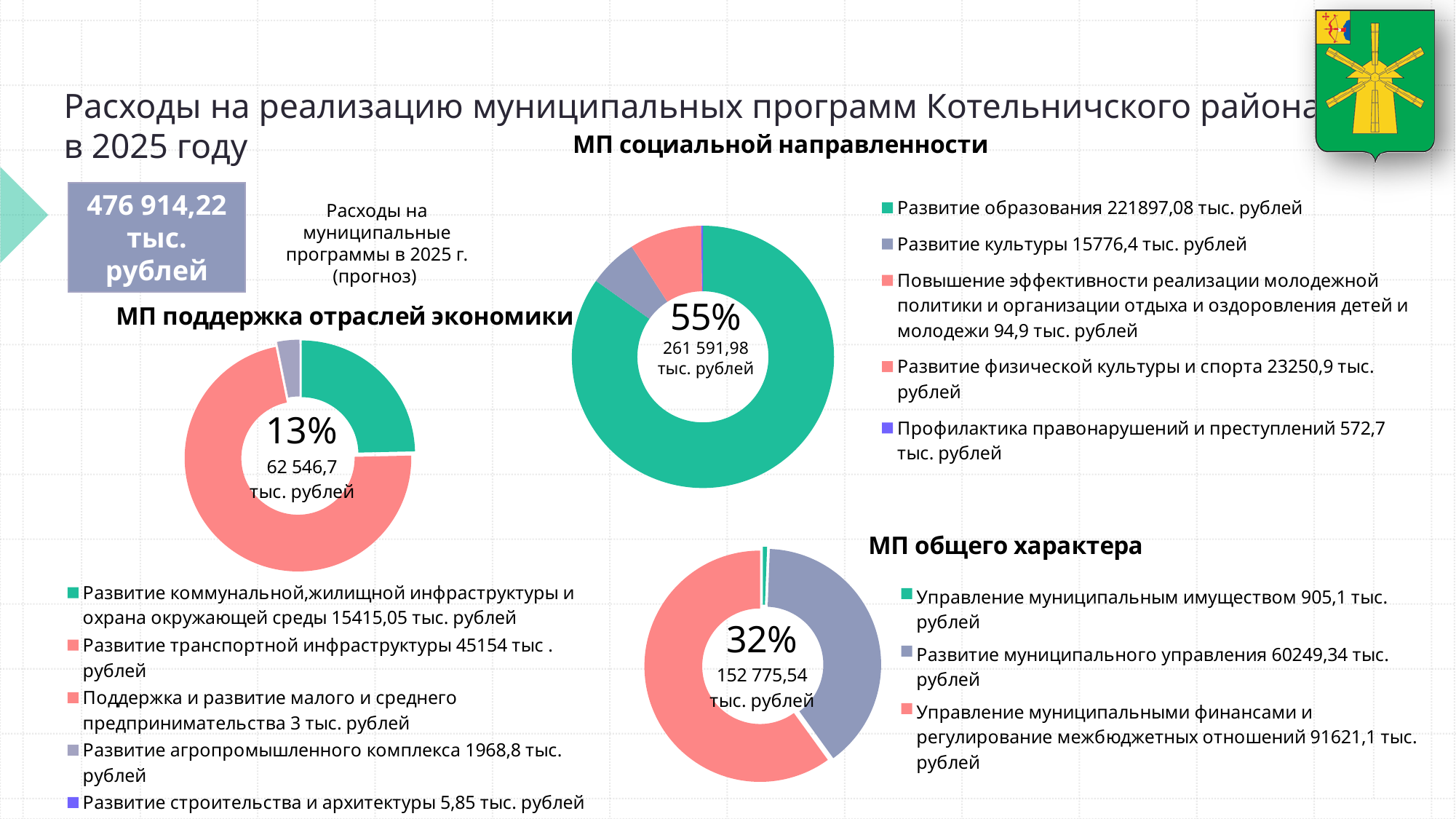
In the 'МП социальной направленности' chart, what is the value for 'Развитие образования'? 221897,08 тыс. рублей How many programs are listed in the legend of the 'МП социальной направленности' chart? 5 In the 'МП поддержка отраслей экономики' chart, which program has the largest value? Развитие транспортной инфраструктуры In the 'МП общего характера' chart, what is the difference between 'Управление муниципальными финансами и регулирование межбюджетных отношений' and 'Развитие муниципального управления'? 31371,76 тыс. рублей In the 'МП поддержка отраслей экономики' chart, which program has the smallest value? Поддержка и развитие малого и среднего предпринимательства What total amount is shown in the centre of the 'МП общего характера' chart? 152 775,54 тыс. рублей What share of total expenditure is shown in the centre of the 'МП социальной направленности' chart? 55% In the 'МП общего характера' chart, what is the value for 'Развитие муниципального управления'? 60249,34 тыс. рублей In the 'МП социальной направленности' chart, which program has the smallest value? Повышение эффективности реализации молодежной политики и организации отдыха и оздоровления детей и молодежи In the 'МП социальной направленности' chart, which is larger: 'Развитие культуры' or 'Развитие физической культуры и спорта'? Развитие физической культуры и спорта What kind of chart is used for 'МП поддержка отраслей экономики'? Donut (pie) chart How many programs are listed in the legend of the 'МП общего характера' chart? 3